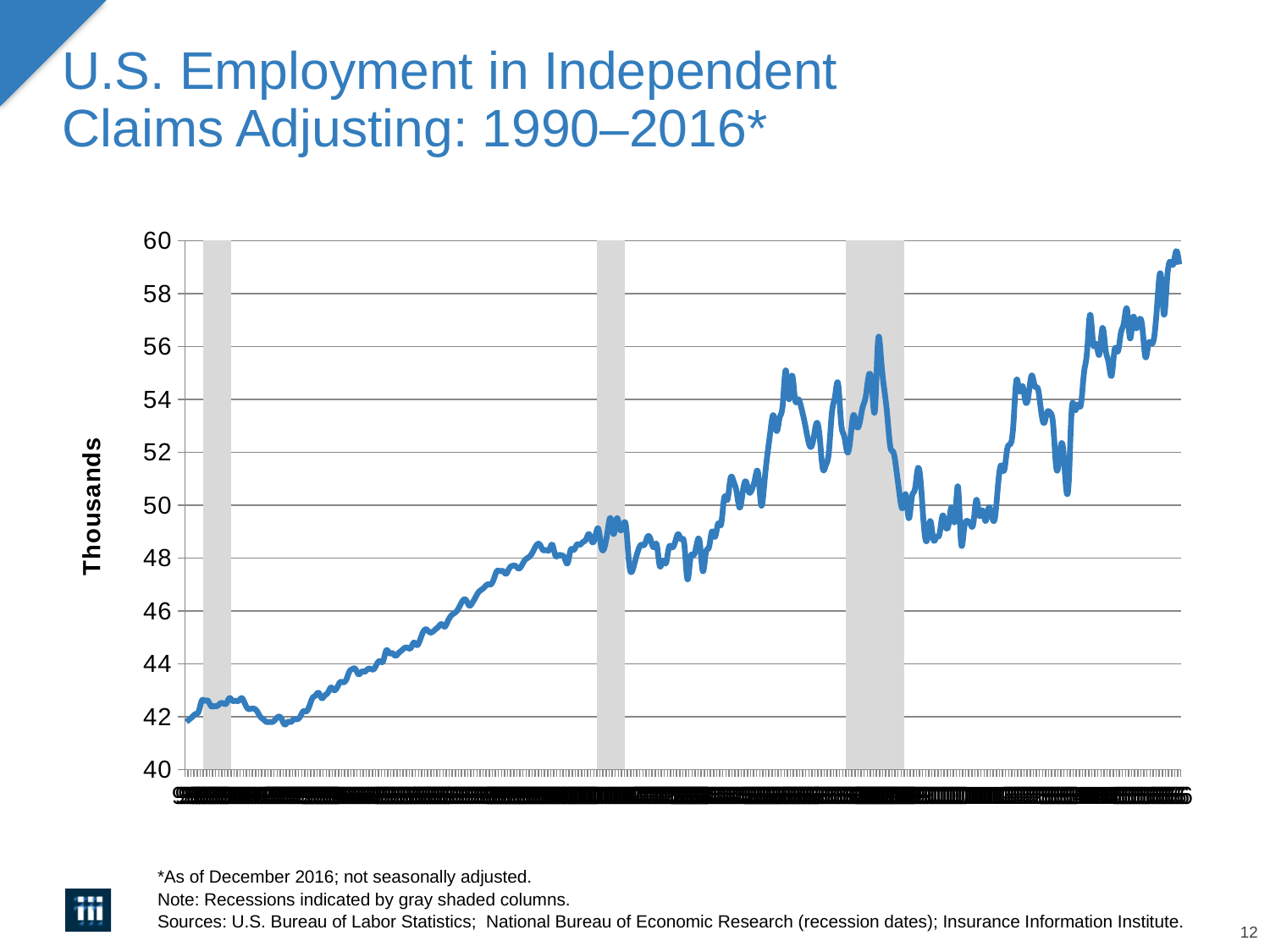
What is the title of the chart on the slide? U.S. Employment in Independent Claims Adjusting: 1990–2016* How many data series are plotted on the chart? 1 Is the value at the end of the series (December 2016) greater or less than 58? greater What kind of chart is shown on the slide? line chart Is the value at the start of the series (1990) greater or less than 44? less What is the label on the vertical axis of the chart? Thousands What is the highest value shown on the vertical axis? 60 Is the highest point on the line greater or less than 58? greater Overall, do the values rise or fall from the start of the series to the end? rise